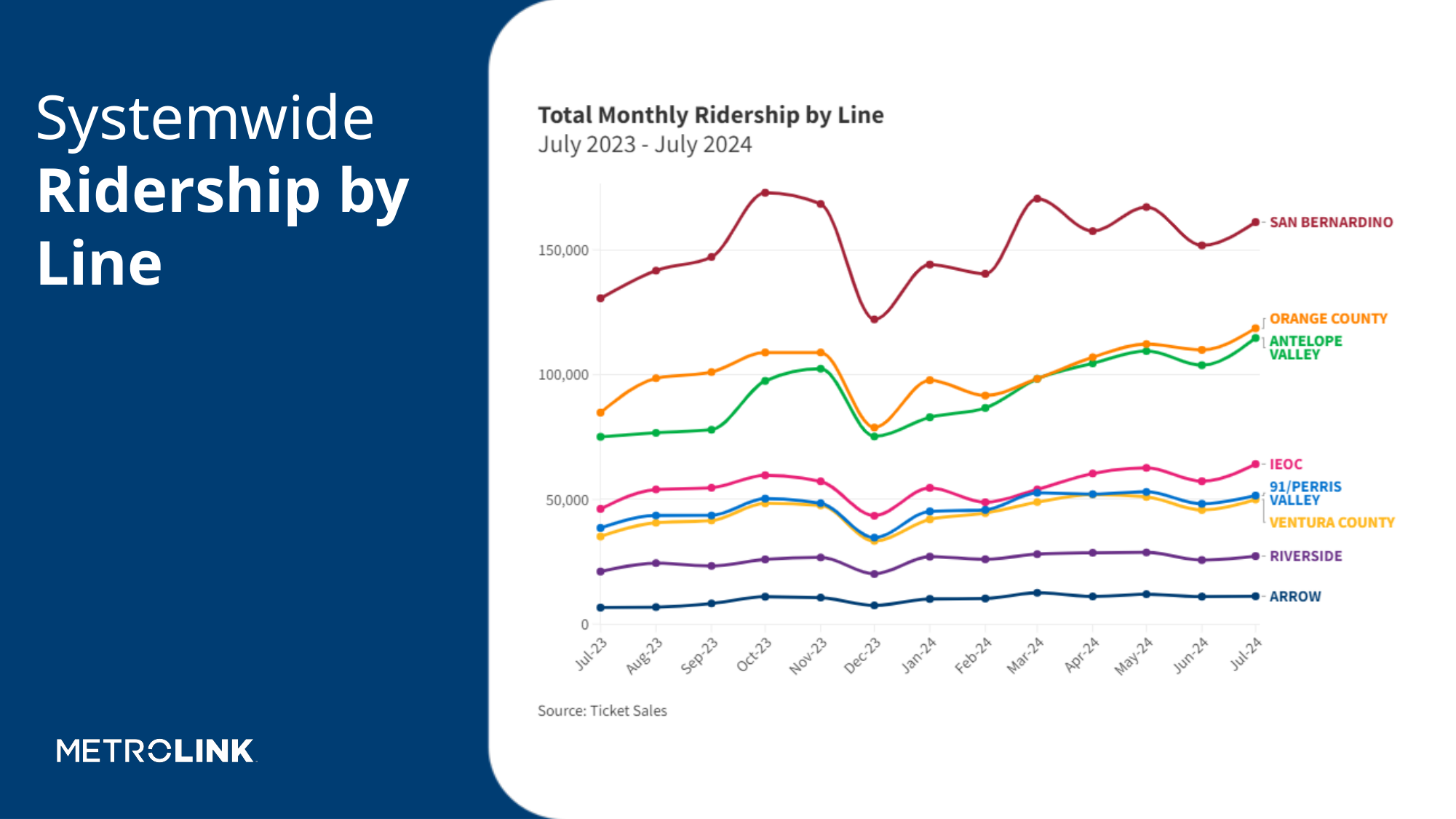
What kind of chart is shown on the slide? Line chart How many months are shown along the x axis? 13 Is the value for Antelope Valley in Jul-23 greater or less than 100,000? less Does the Antelope Valley line rise or fall from Dec-23 to Jul-24? Rise Is the value for San Bernardino in Dec-23 greater or less than 150,000? less Which is larger in Jul-24, Orange County or IEOC? Orange County How many lines (series) are plotted on the chart? 8 What is the title of the chart? Total Monthly Ridership by Line Which line has the lowest ridership throughout the period? Arrow Is the value for Riverside in Jul-24 greater or less than 50,000? less Which line has the highest ridership throughout the period? San Bernardino